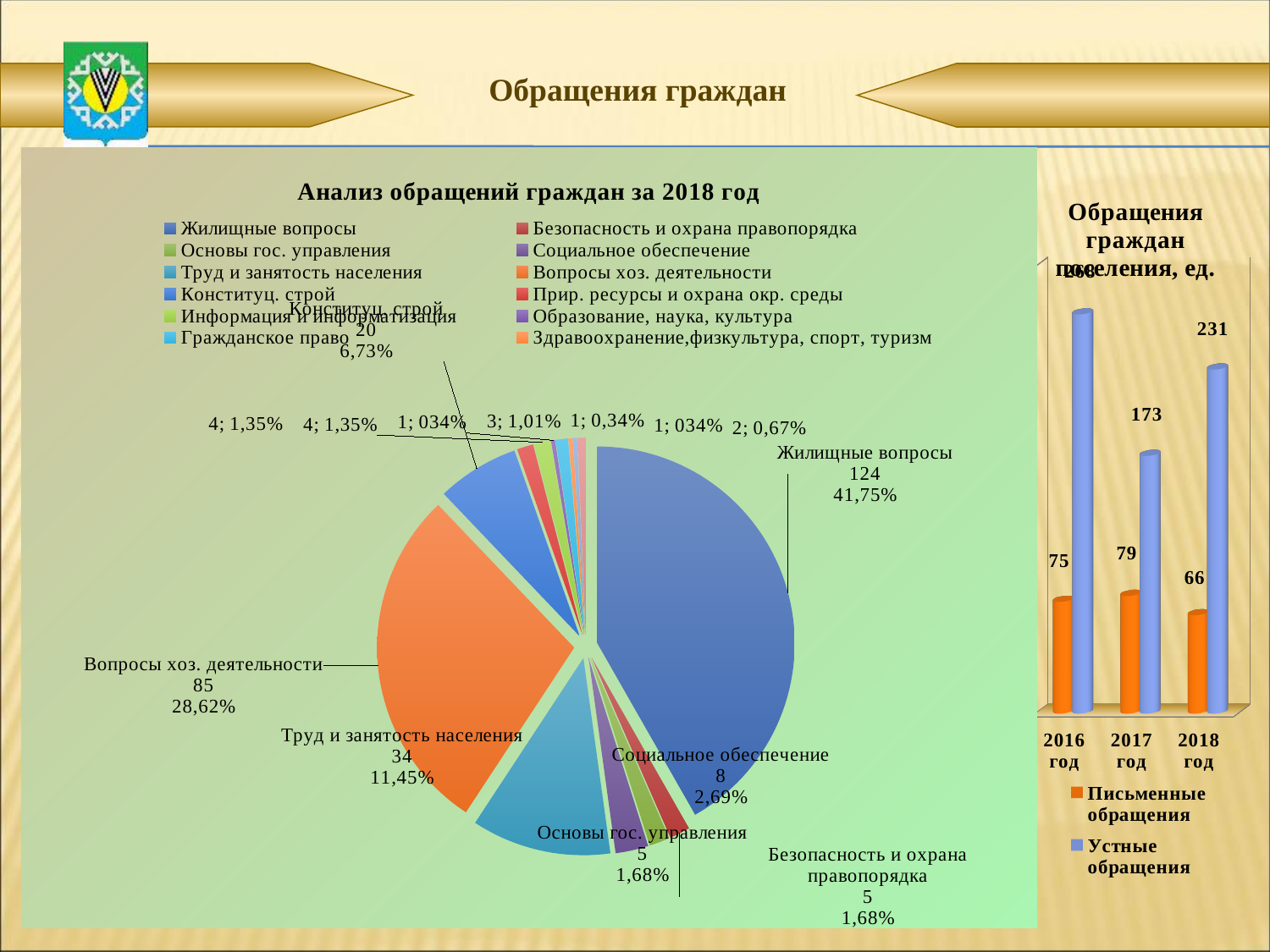
On the pie chart 'Анализ обращений граждан за 2018 год', which category has the largest slice? Жилищные вопросы On the bar chart 'Обращения граждан поселения, ед.', what is the value of Устные обращения for 2018 год? 231 On the pie chart 'Анализ обращений граждан за 2018 год', which is larger: Социальное обеспечение or Конституц. строй? Конституц. строй On the pie chart 'Анализ обращений граждан за 2018 год', what is the value for Труд и занятость населения? 34 On the pie chart 'Анализ обращений граждан за 2018 год', what is the difference between the values for Жилищные вопросы and Вопросы хоз. деятельности? 39 On the pie chart 'Анализ обращений граждан за 2018 год', what is the value for Жилищные вопросы? 124 On the bar chart 'Обращения граждан поселения, ед.', what is the value of Письменные обращения for 2017 год? 79 On the pie chart 'Анализ обращений граждан за 2018 год', how many entries does the legend list? 12 On the bar chart 'Обращения граждан поселения, ед.', which year has the lowest value of Письменные обращения? 2018 год On the bar chart 'Обращения граждан поселения, ед.', what is the difference between Устные обращения in 2018 год and 2017 год? 58 What kind of chart is 'Анализ обращений граждан за 2018 год'? Pie chart On the pie chart 'Анализ обращений граждан за 2018 год', what share does Вопросы хоз. деятельности have? 28,62%